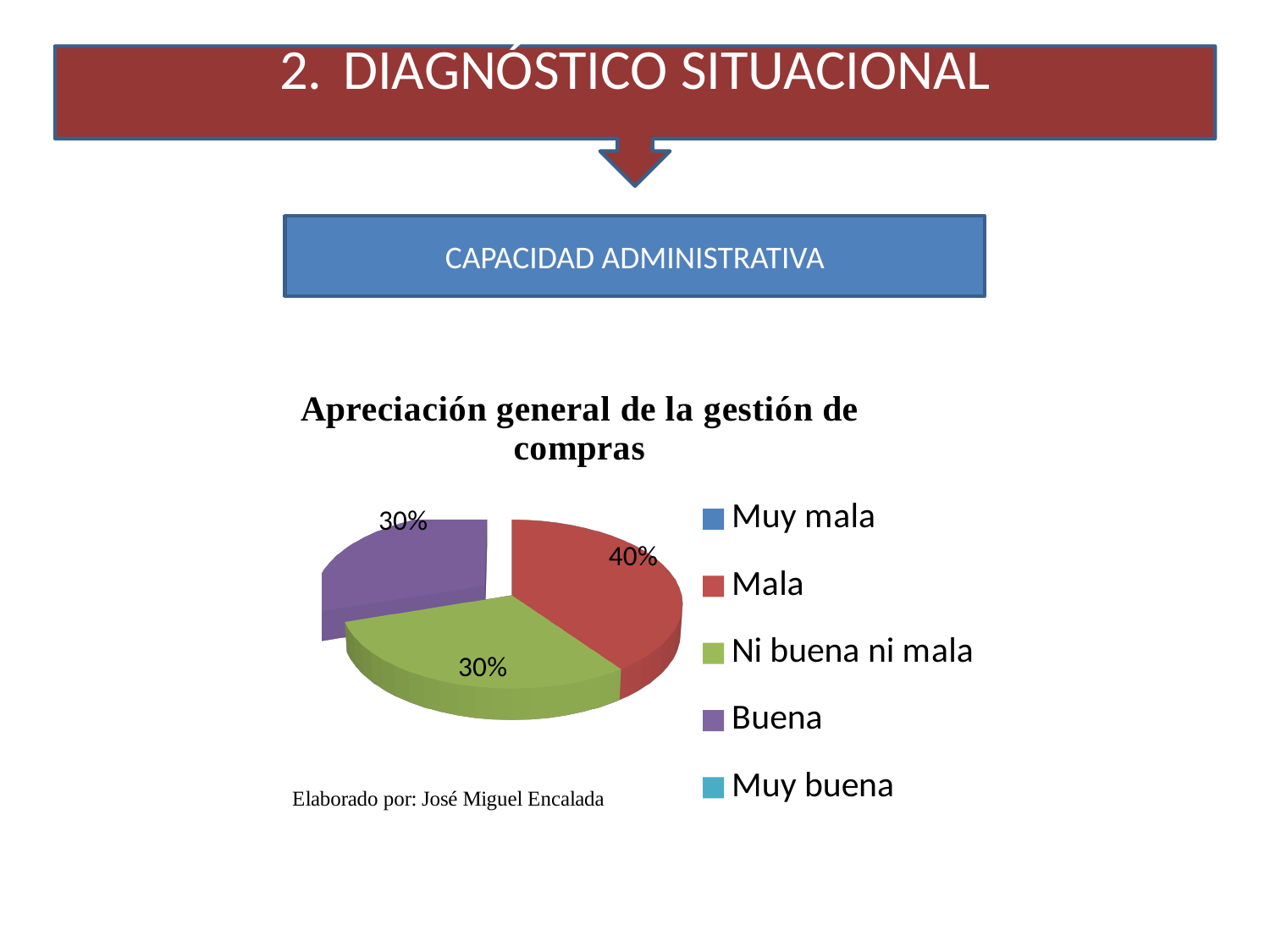
What is the title of the chart? Apreciación general de la gestión de compras Which category has the largest slice of the pie? Mala Which is larger, the slice for "Mala" or the slice for "Buena"? Mala What percentage of the pie corresponds to "Ni buena ni mala"? 30% What colour is the "Mala" slice in the pie chart? red What is the difference in percentage points between the "Mala" slice and the "Buena" slice? 10 How many slices with a visible percentage label are shown in the pie? 3 What share of the pie does "Mala" represent? 40% What percentage of the pie corresponds to "Buena"? 30% What kind of chart is shown on the slide? pie chart What percentage of the pie corresponds to "Mala"? 40% How many entries does the legend list? 5